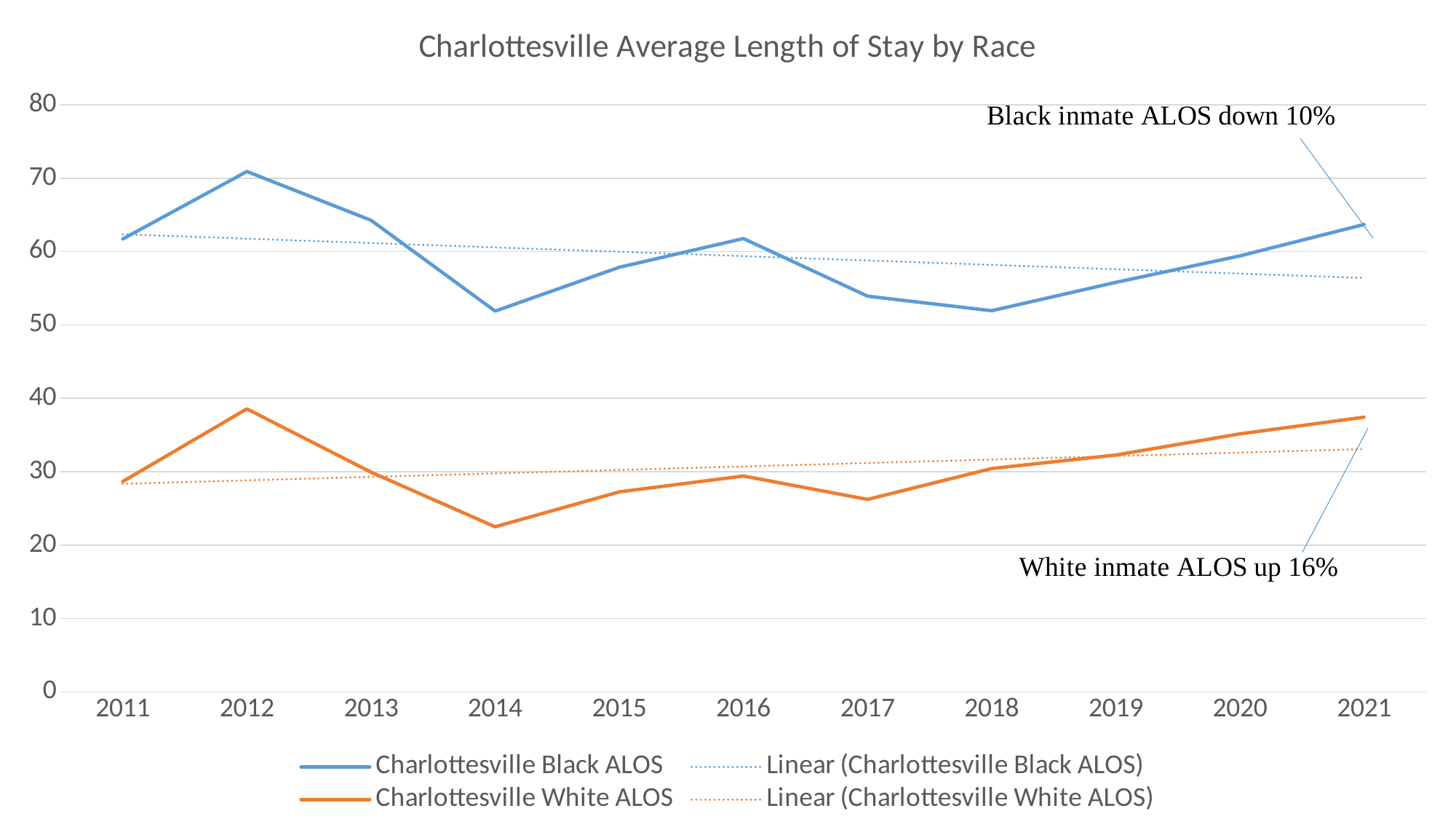
How many years are shown on the x axis? 11 According to the annotation on the chart, by what percentage is Black inmate ALOS down? 10% Does the Charlottesville White ALOS rise or fall from 2017 to 2021? Rise What type of chart is shown on the slide? Line chart How many series does the legend list? 4 Is the Charlottesville Black ALOS value for 2014 greater or less than 60? less What is the title of the chart? Charlottesville Average Length of Stay by Race In which year is the Charlottesville Black ALOS highest? 2012 In which year is the Charlottesville White ALOS lowest? 2014 In which year is the Charlottesville White ALOS highest? 2012 Which is larger: the Charlottesville White ALOS in 2011 or in 2021? 2021 Is the Charlottesville White ALOS value for 2021 greater or less than 30? greater